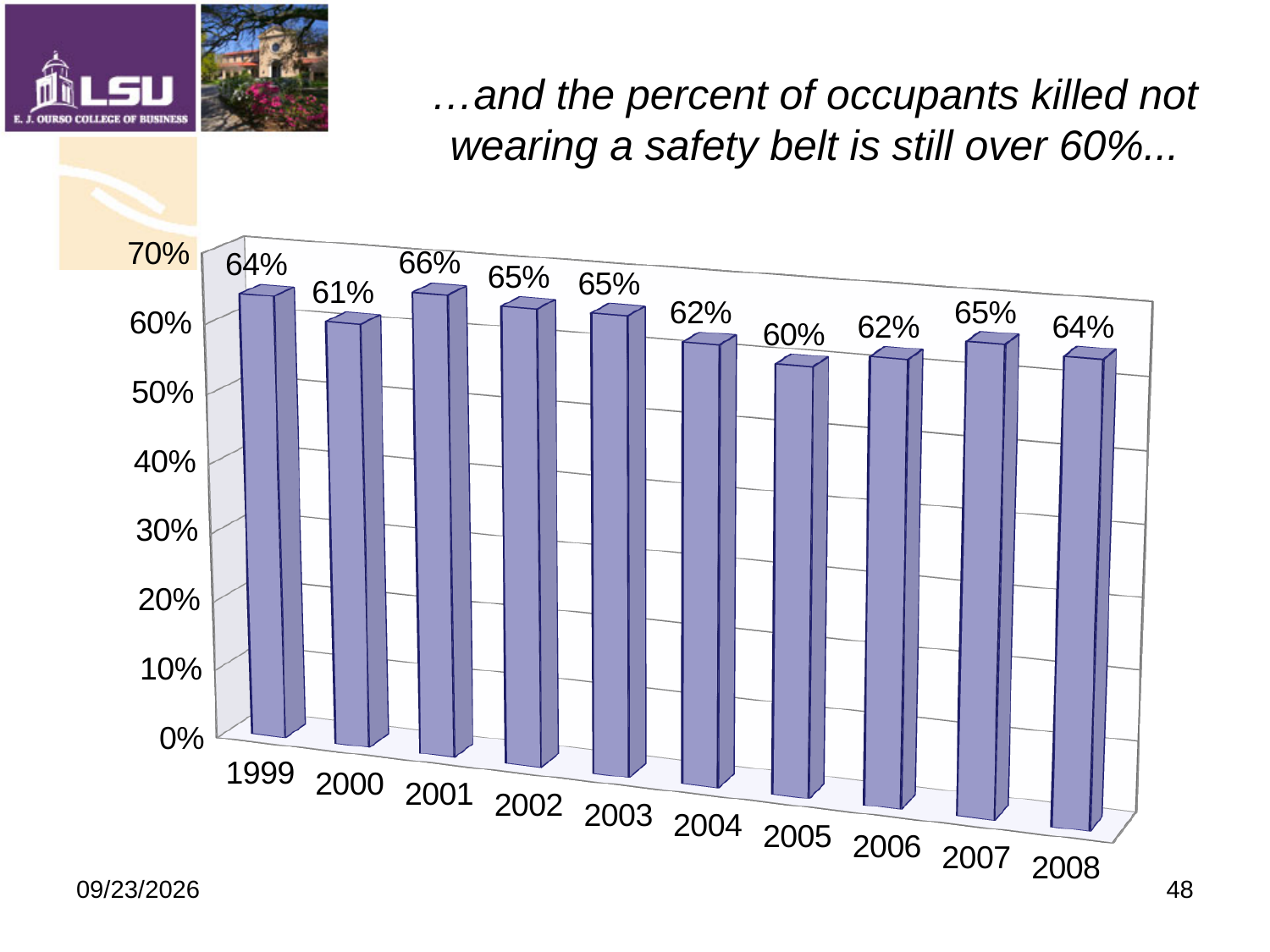
Which is larger, the value for 2002 or the value for 2004? 2002 Is the value for 2006 greater or less than 50%? greater What is the difference between the values for 2001 and 2005? 6% What is the value for 1999? 64% What is the difference between the values for 2000 and 2007? 4% What is the value for 2008? 64% What kind of chart is shown on the slide? Bar chart What is the value for 2005? 60% How many years are shown on the x axis? 10 Which year has the lowest value? 2005 Which year has the highest value? 2001 What is the value for 2003? 65%